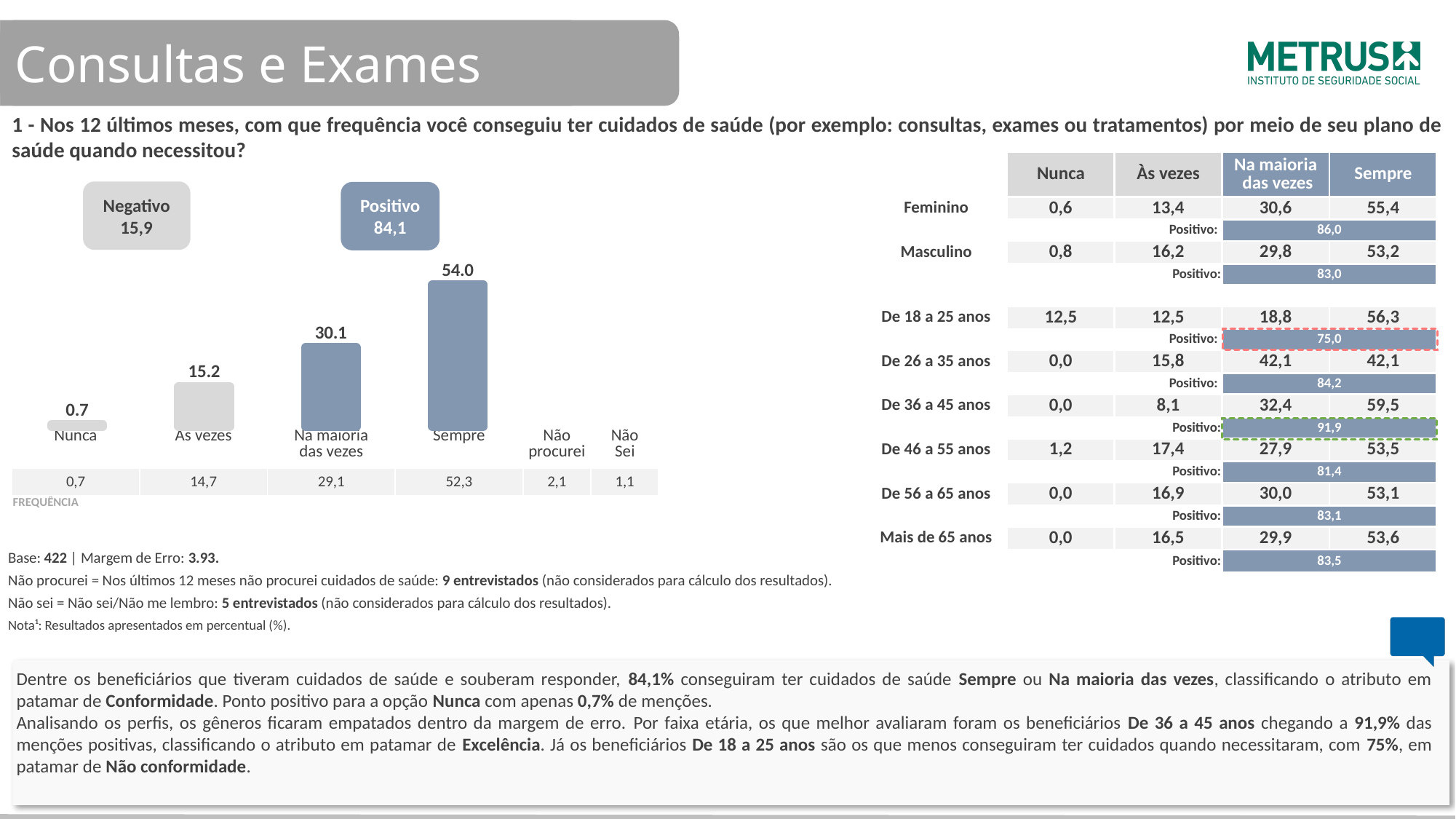
What is the value of the Na maioria das vezes bar in the bar chart? 30.1 What value is shown in the Positivo box above the bar chart? 84,1 What is the value of the Nunca bar in the bar chart? 0.7 Which is larger in the bar chart, As vezes or Na maioria das vezes? Na maioria das vezes Which category has the lowest bar in the chart? Nunca What is the value of the As vezes bar in the bar chart? 15.2 What is the difference between the Sempre bar and the Na maioria das vezes bar? 23.9 Which category has the highest bar in the chart? Sempre Do the bar values rise or fall from Nunca to Sempre along the x axis? Rise What is the difference between the As vezes bar and the Nunca bar? 14.5 What kind of chart is shown on the left of the slide? Bar chart What is the value of the Sempre bar in the bar chart? 54.0